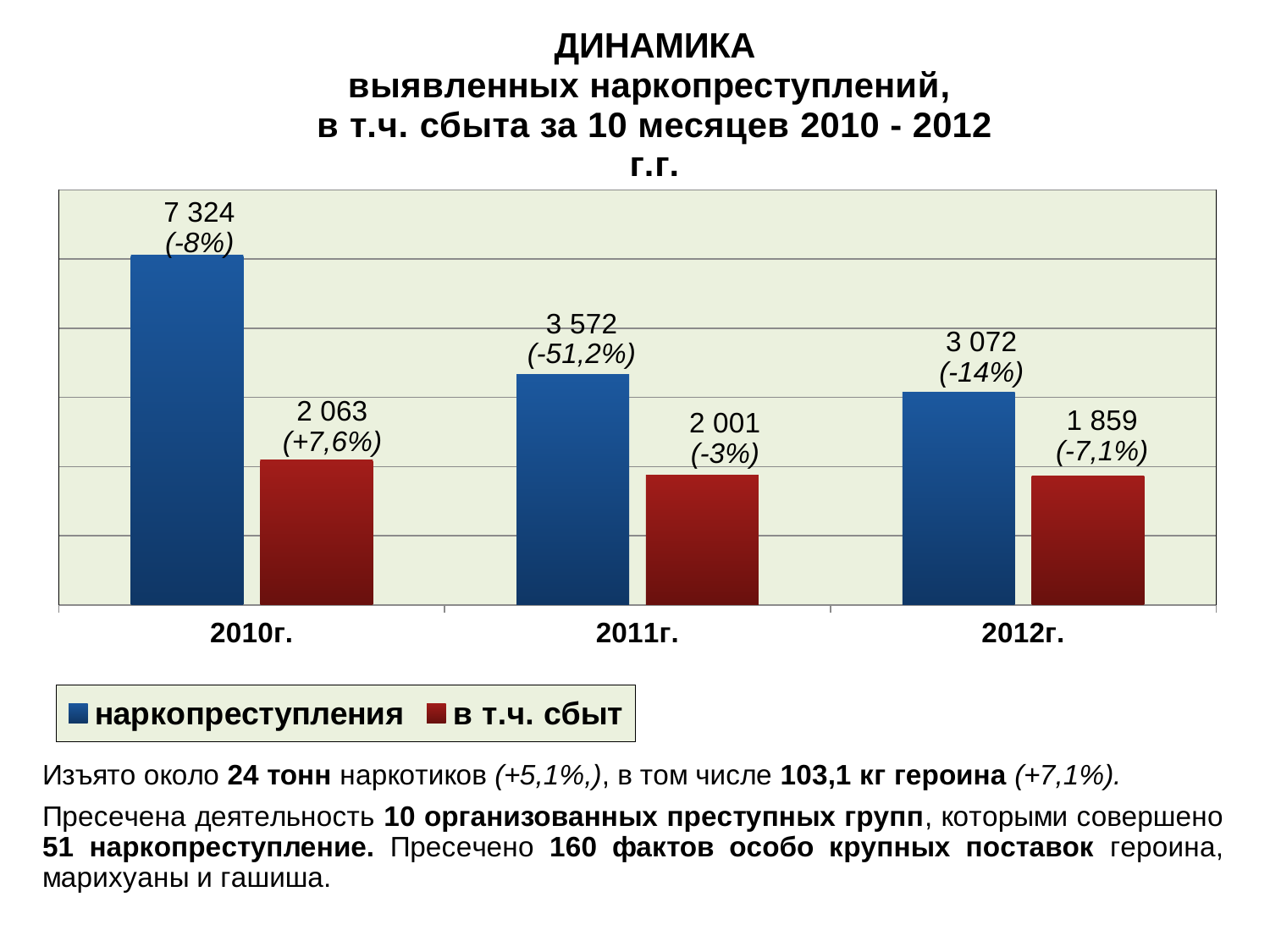
Do the наркопреступления values rise or fall from 2010г. to 2012г.? fall How many series does the legend list? 2 What is the difference between the наркопреступления values for 2010г. and 2011г.? 3 752 What percentage change is shown next to the в т.ч. сбыт value for 2010г.? +7,6% What is the value for наркопреступления in 2011г.? 3 572 What is the value for в т.ч. сбыт in 2012г.? 1 859 How many years are shown on the x axis? 3 In which year is the наркопреступления value highest? 2010г. What is the difference between the наркопреступления and в т.ч. сбыт values in 2012г.? 1 213 In which year is the в т.ч. сбыт value lowest? 2012г. What is the value for наркопреступления in 2010г.? 7 324 Which is larger: в т.ч. сбыт in 2011г. or в т.ч. сбыт in 2012г.? в т.ч. сбыт in 2011г.